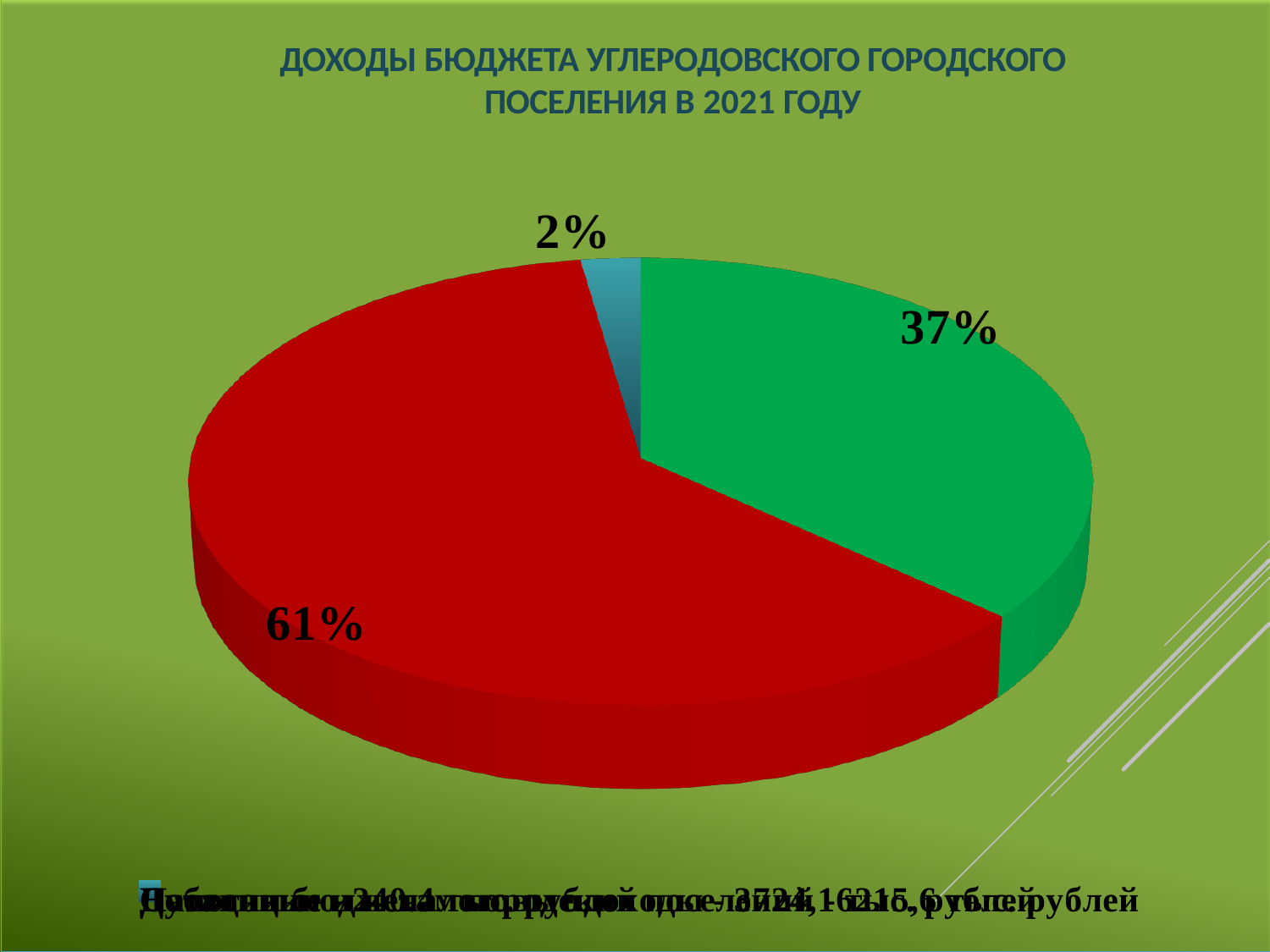
What percentage is shown for the small blue slice of the pie? 2% What is the difference in percentage points between the green slice and the blue slice? 35 What percentage is shown for the green slice of the pie? 37% What is the title of the chart? ДОХОДЫ БЮДЖЕТА УГЛЕРОДОВСКОГО ГОРОДСКОГО ПОСЕЛЕНИЯ В 2021 ГОДУ What is the smallest share shown on the pie chart? 2% What is the difference in percentage points between the red slice and the green slice? 24 What percentage is shown for the red slice of the pie? 61% How many slices does the pie chart have? 3 Which colour is the largest slice of the pie? Red What kind of chart is shown on the slide? Pie chart Which slice is larger, the red one or the green one? The red one What is the largest share shown on the pie chart? 61%